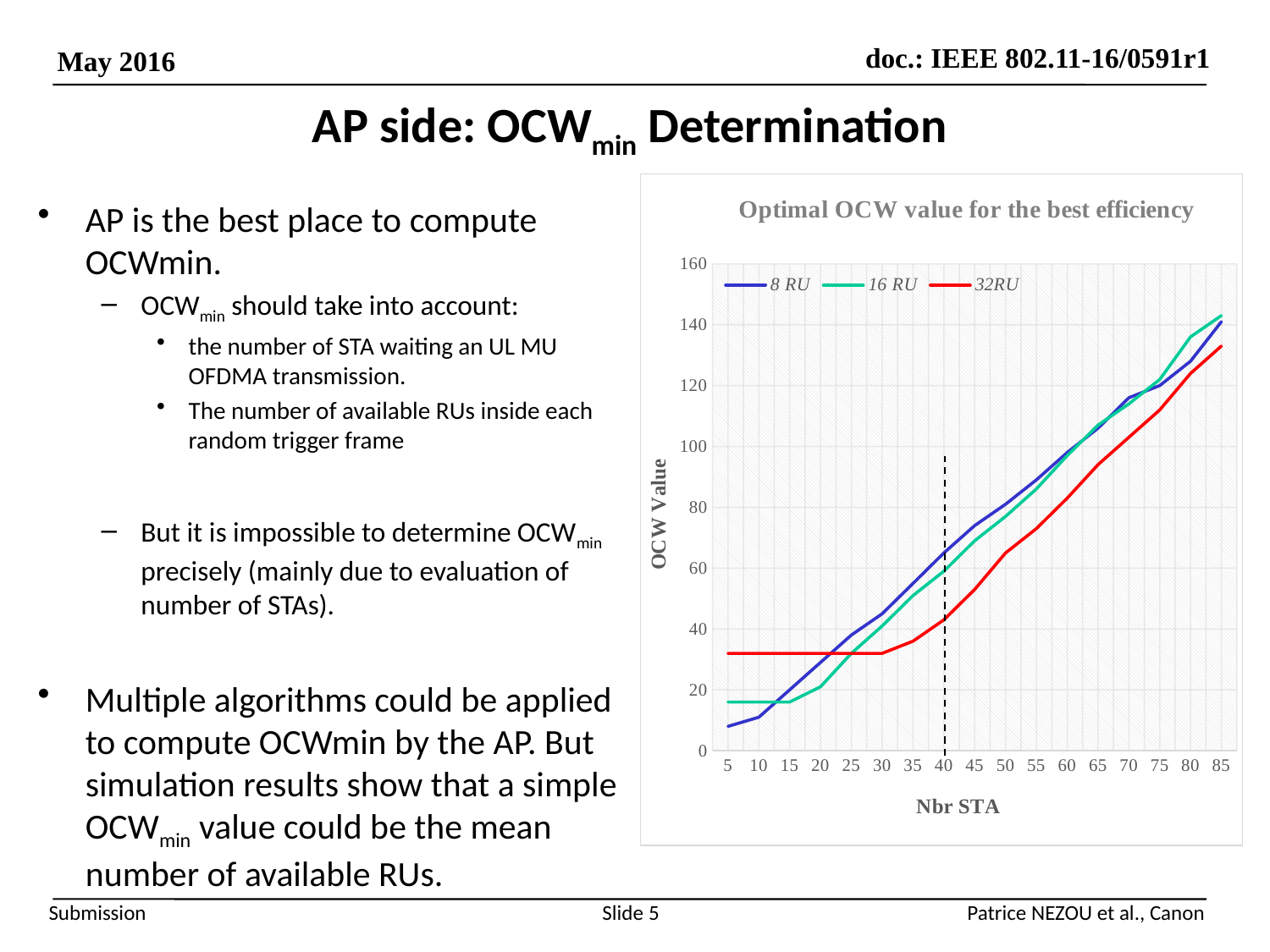
Is the OCW value for 32RU at 30 STAs greater or less than 40? less At 40 STAs, which series has the higher OCW value, 8 RU or 32RU? 8 RU Is the OCW value for 8 RU at 85 STAs greater or less than 120? greater Is the OCW value for 32RU at 5 STAs greater or less than 20? greater What is the title of the chart's x axis? Nbr STA Which series has the lowest OCW value at 85 STAs? 32RU How many Nbr STA values are marked along the x axis of the chart? 17 Do the OCW values for the 8 RU series rise or fall as Nbr STA increases? rise How many series does the chart legend list? 3 At 5 STAs, which series has the higher OCW value, 8 RU or 32RU? 32RU What kind of chart is shown on the slide? line chart